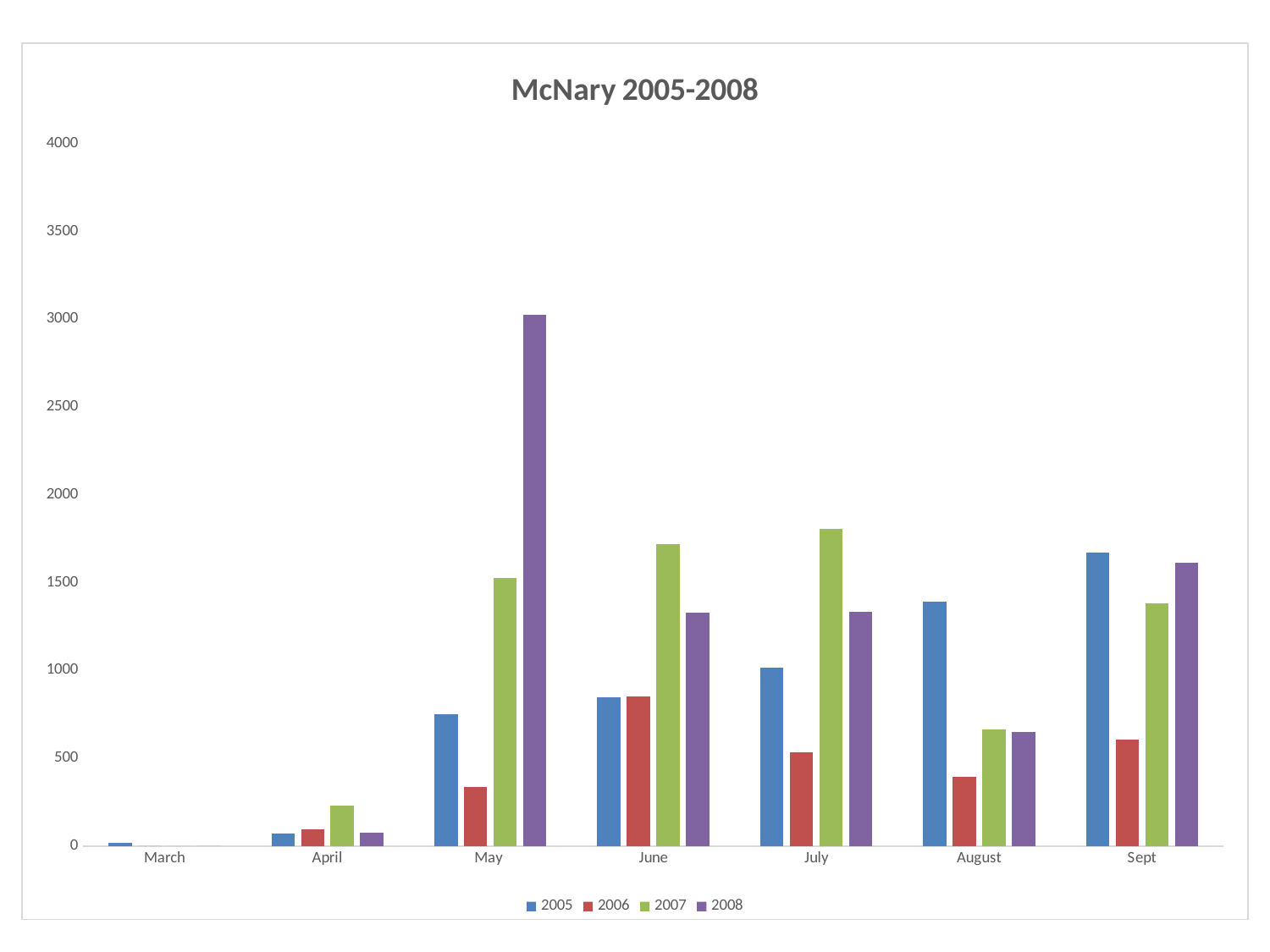
Which series has the highest value in August? 2005 How many series does the legend list? 4 Which series has the lowest value in July? 2006 Is the 2008 value for May greater or less than 2500? greater What kind of chart is shown on the slide? bar chart Is the 2006 value for May greater or less than 500? less In June, which is larger: the 2007 value or the 2008 value? 2007 What is the title of the chart? McNary 2005-2008 Is the 2007 value for July greater or less than 1500? greater In which month is the 2007 value highest? July How many months are shown on the x axis? 7 In which month is the 2008 value highest? May